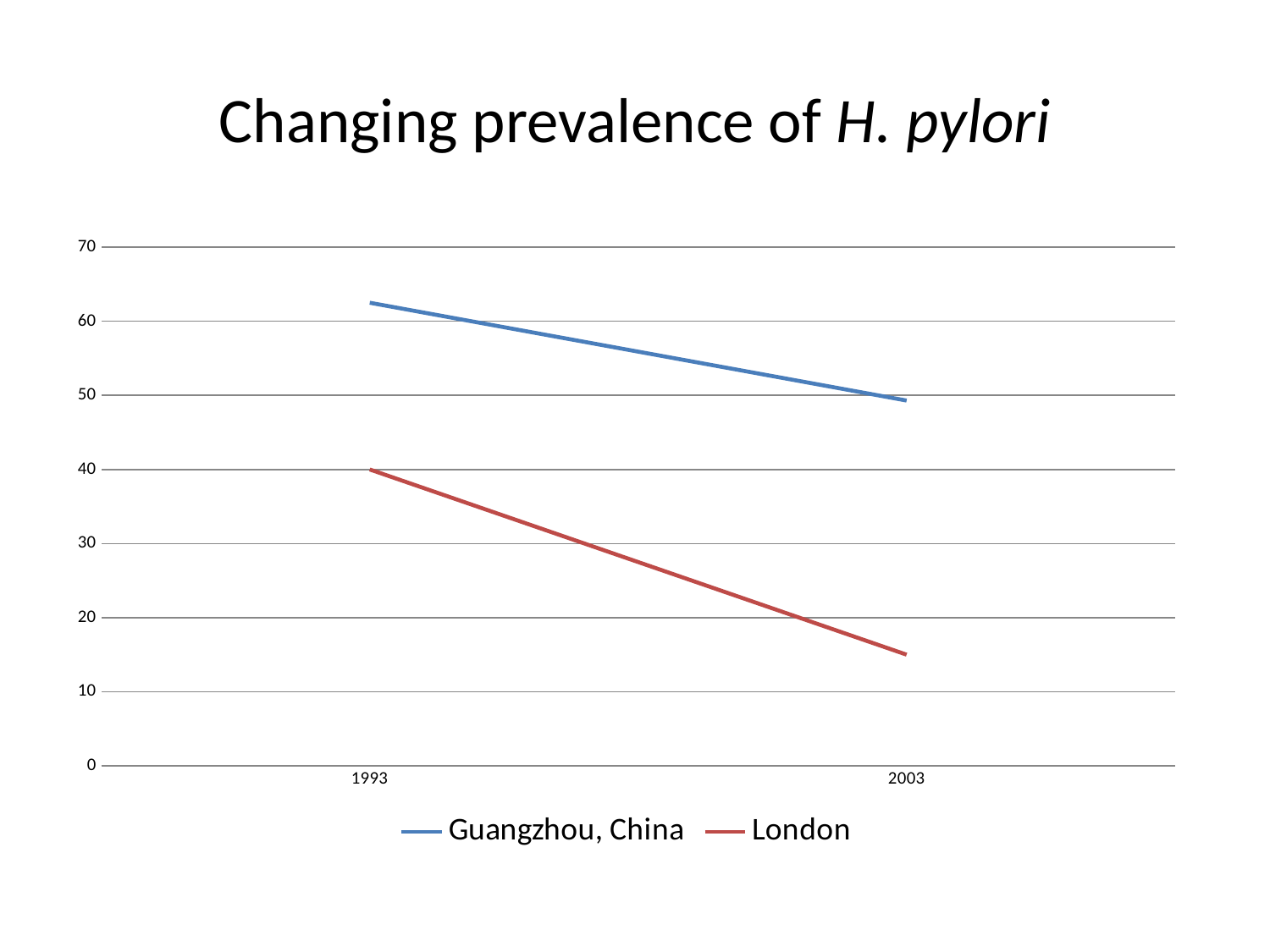
How many series does the legend list? 2 What kind of chart is shown on the slide? line chart Which series has the higher value in 2003, Guangzhou, China or London? Guangzhou, China Does the prevalence for London rise or fall from 1993 to 2003? fall Does the prevalence for Guangzhou, China rise or fall from 1993 to 2003? fall Is the value for London in 2003 greater or less than 20? less Is the value for Guangzhou, China in 1993 greater or less than 60? greater What is the title of the chart? Changing prevalence of H. pylori Which series has the lowest value in 1993? London Is the value for Guangzhou, China in 2003 greater or less than 40? greater Which colour is used for the London line? red How many years are shown on the x axis? 2